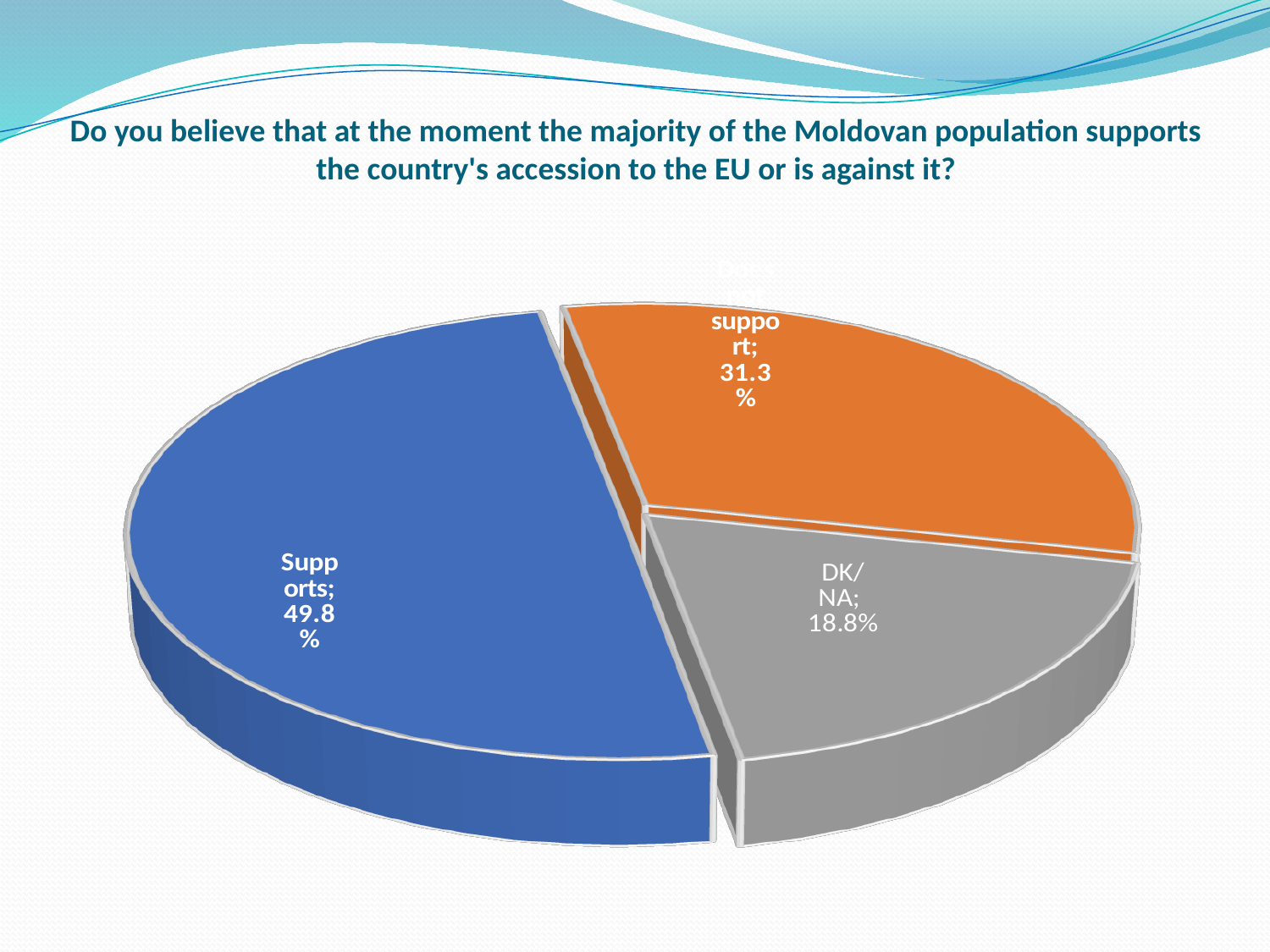
Which category has the largest share of the pie? Supports What kind of chart is shown on the slide? pie chart What percentage of respondents answered "DK/NA"? 18.8% What percentage of respondents answered "Supports"? 49.8% What is the difference in percentage points between "Does not support" and "DK/NA"? 12.5 How many slices does the pie chart have? 3 What colour is the "DK/NA" slice? grey What is the difference in percentage points between "Supports" and "Does not support"? 18.5 Which is larger, the share for "Does not support" or the share for "DK/NA"? Does not support What colour is the "Supports" slice? blue Which category has the smallest share of the pie? DK/NA What percentage of respondents answered "Does not support"? 31.3%